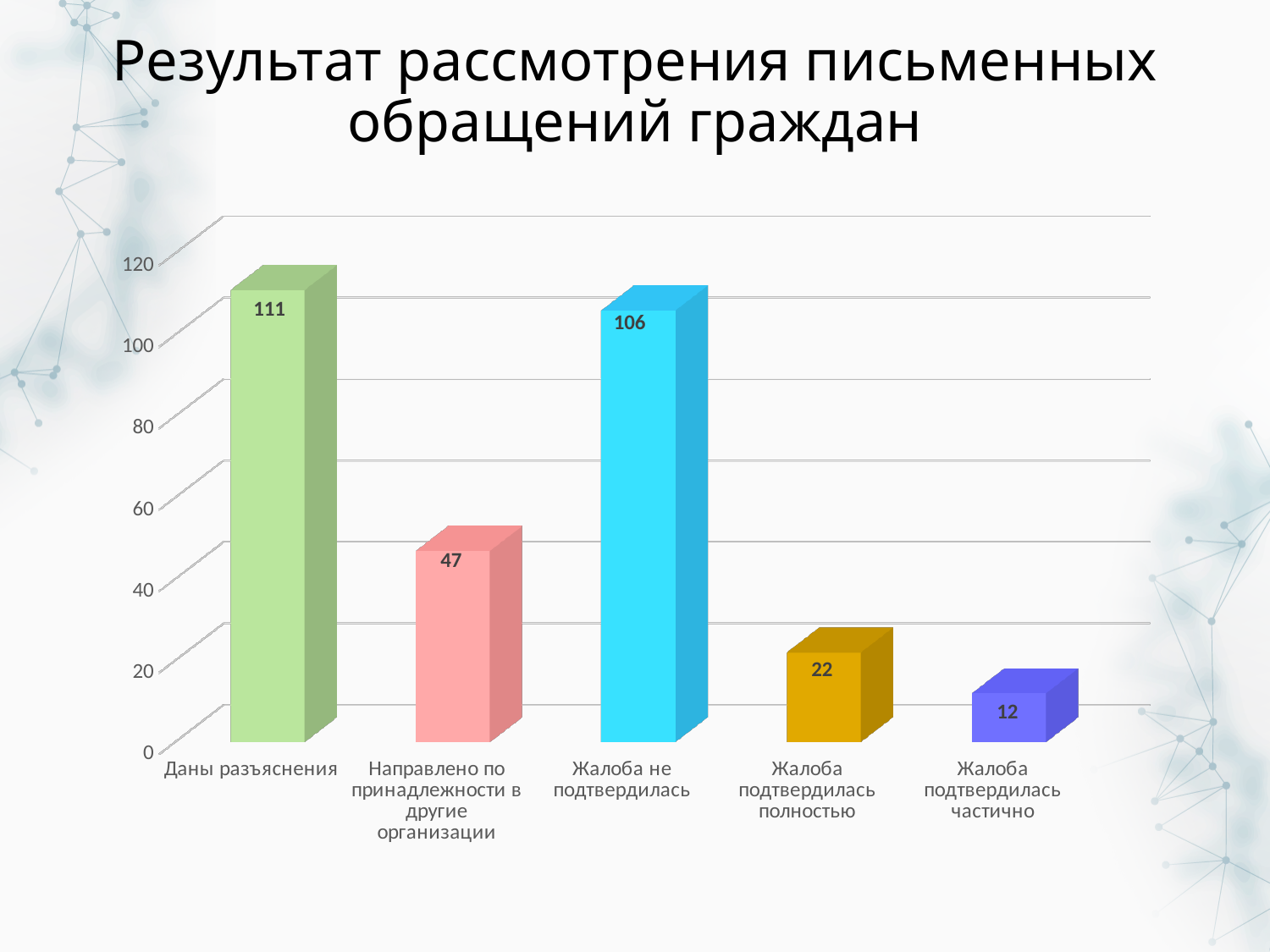
How many categories are shown in the chart? 5 What is the title of the slide? Результат рассмотрения письменных обращений граждан Which category has the lowest value? Жалоба подтвердилась частично What is the value for "Жалоба не подтвердилась"? 106 What is the value for "Направлено по принадлежности в другие организации"? 47 What kind of chart is shown on the slide? Bar chart What is the difference between the values for "Даны разъяснения" and "Жалоба не подтвердилась"? 5 What is the value for "Даны разъяснения"? 111 Which is larger: the value for "Направлено по принадлежности в другие организации" or the value for "Жалоба подтвердилась полностью"? Направлено по принадлежности в другие организации What is the difference between the values for "Жалоба подтвердилась полностью" and "Жалоба подтвердилась частично"? 10 Which category has the highest value? Даны разъяснения What is the value for "Жалоба подтвердилась частично"? 12